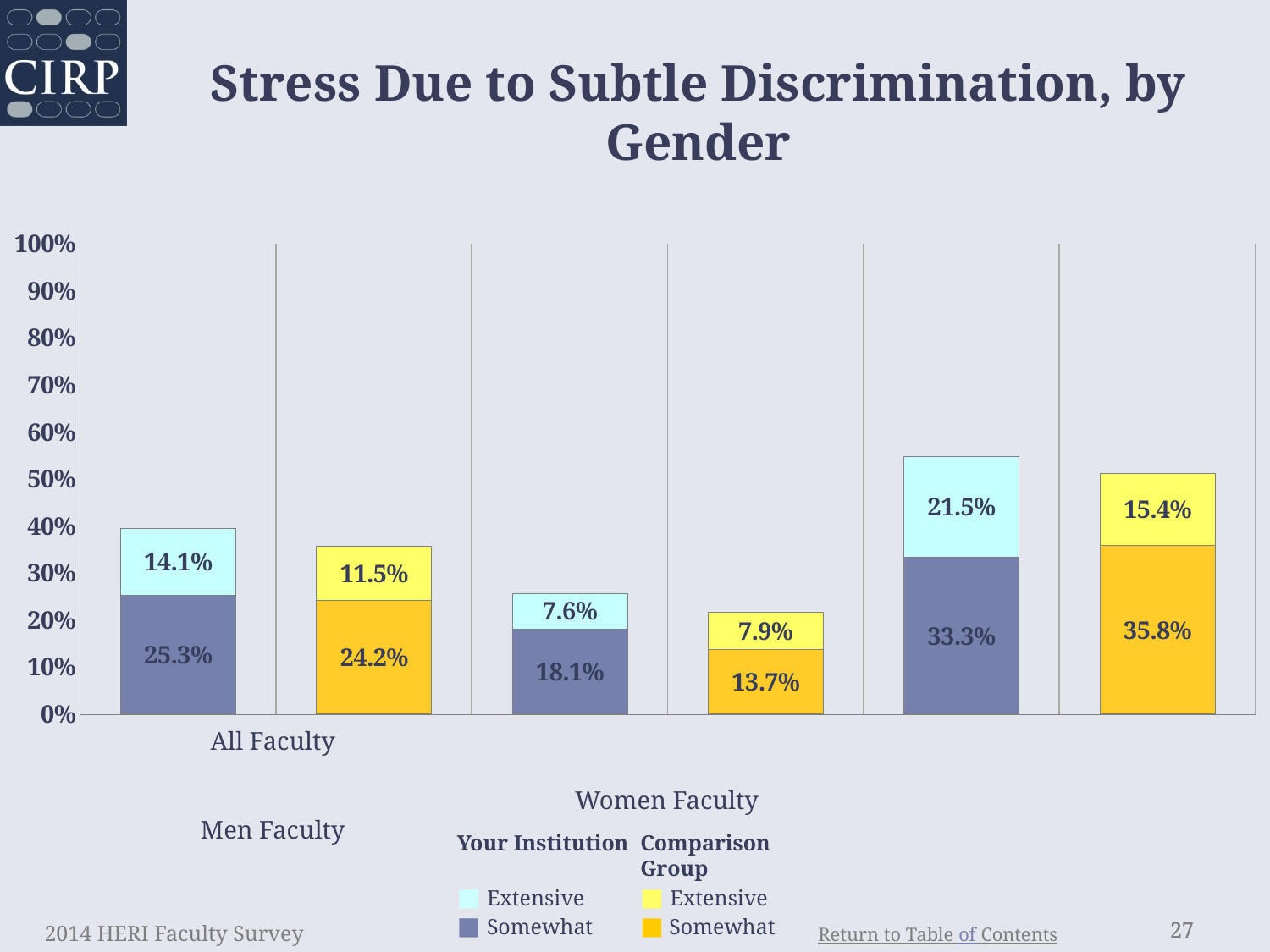
How many series does the legend list? 4 Which faculty group has the lowest Somewhat value in the Comparison Group? Men Faculty What is the total height of the Comparison Group stacked bar for All Faculty? 35.7% What is the Somewhat value for All Faculty in the Comparison Group? 24.2% What percentage of Women Faculty at Your Institution report Somewhat stress due to subtle discrimination? 33.3% What type of chart is shown on the slide? Stacked bar chart What is the total height of the Your Institution stacked bar for Women Faculty? 54.8% Which faculty group has the highest Extensive value for Your Institution? Women Faculty What is the difference between the Extensive values for Women Faculty at Your Institution and in the Comparison Group? 6.1% What is the Extensive value for Men Faculty in the Comparison Group? 7.9% How many faculty groups are shown on the x axis? 3 For Men Faculty, which is larger: the Somewhat value for Your Institution or for the Comparison Group? Your Institution